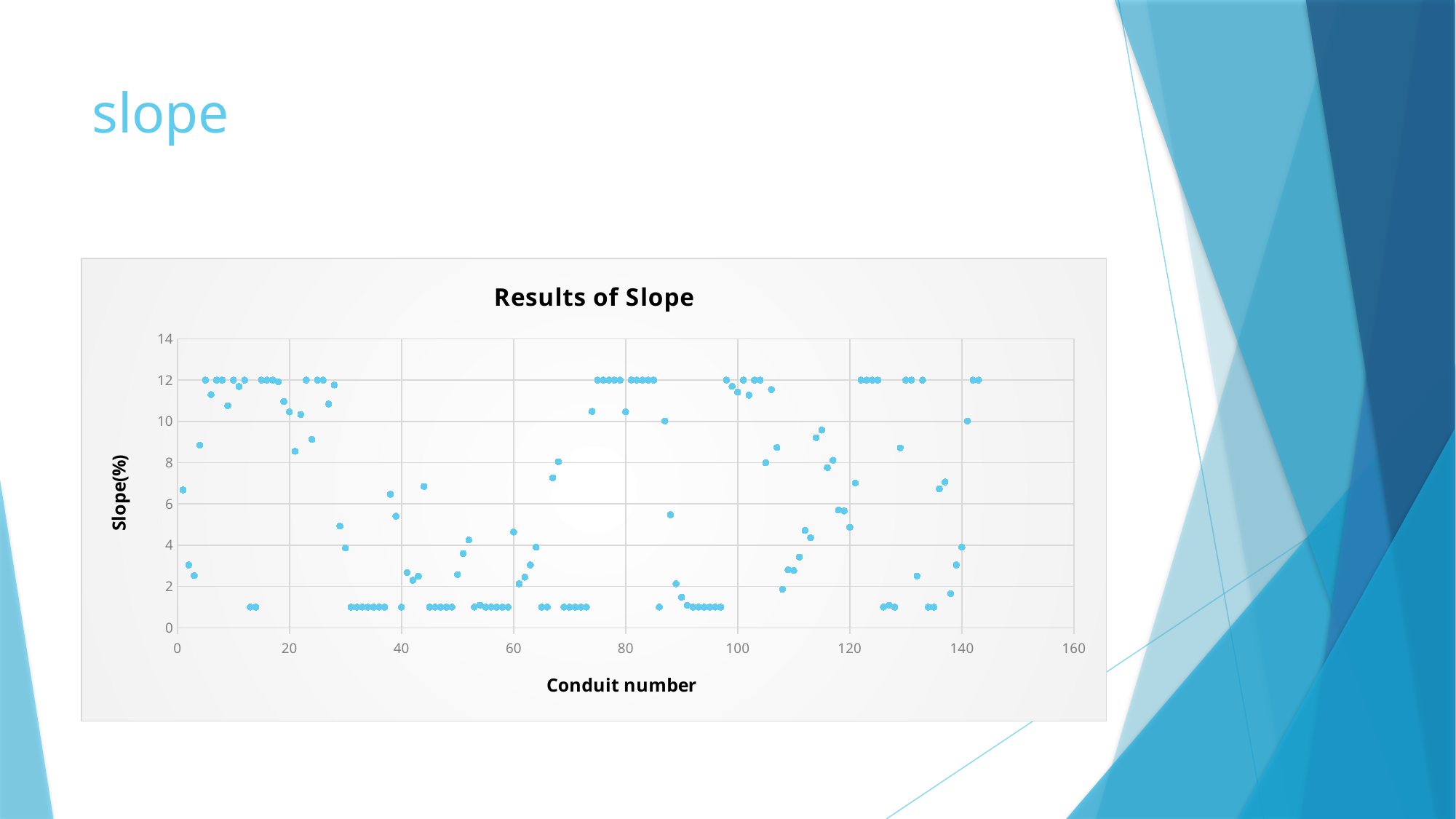
What kind of chart is shown on the slide? scatter chart What is the title of the chart? Results of Slope Do any plotted slope values exceed 12? No Is the slope value for the first conduit (conduit 1) greater or less than 6? greater Are the lowest plotted slope values greater or less than 2? less What is the label on the vertical axis of the chart? Slope(%) What is the highest slope value reached by the plotted points? 12